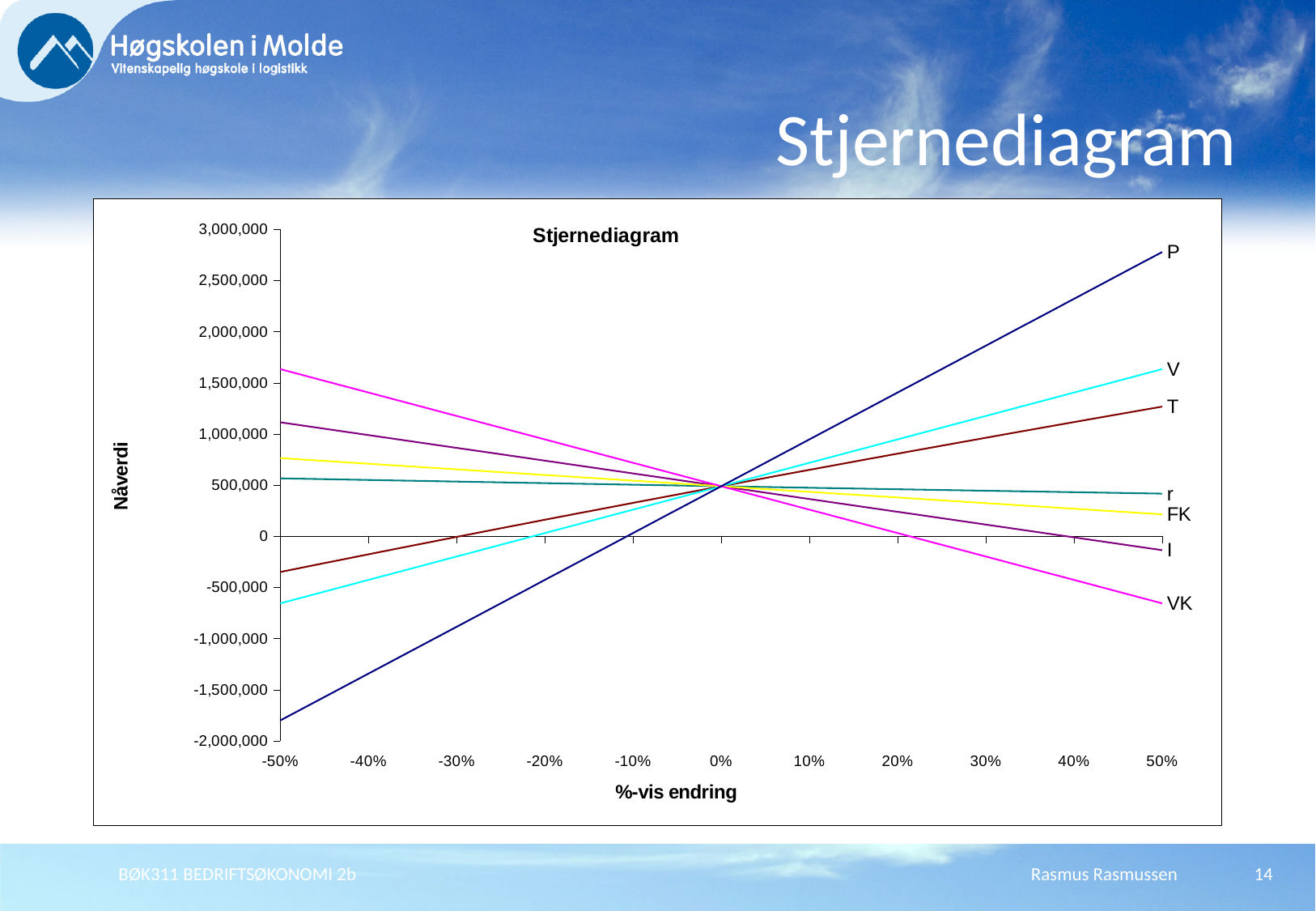
At 50%, which line is higher, V or T? V Which line has the lowest value at -50%? P Is the value of the P line at 50% greater or less than 2,500,000? greater Which line has the highest value at -50%? VK Does the VK line rise or fall as the %-vis endring increases from -50% to 50%? falls Does the P line rise or fall as the %-vis endring increases from -50% to 50%? rises What is the label of the x axis? %-vis endring Which line has the highest value at 50%? P What kind of chart is shown on the slide? line chart What is the title of the chart? Stjernediagram How many lines (series) are labelled on the chart? 7 Which line has the lowest value at 50%? VK